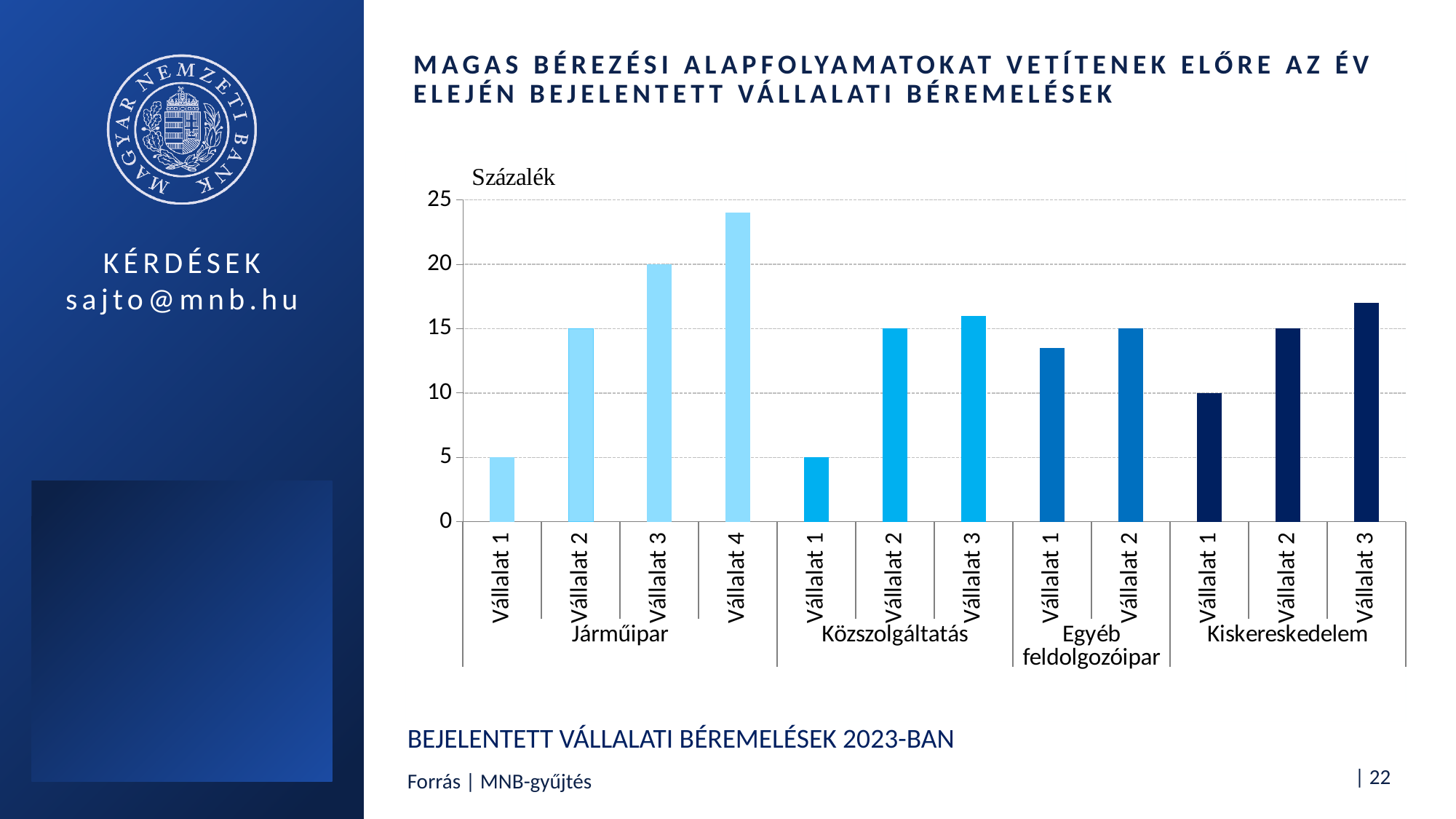
Is the value for Vállalat 4 in the Járműipar group greater or less than 20? greater What is the value for Vállalat 2 in the Közszolgáltatás group? 15 How many bars are plotted on the chart in total? 12 What is the value for Vállalat 1 in the Kiskereskedelem group? 10 Which bar has the highest value on the chart? Vállalat 4 (Járműipar) Is the value for Vállalat 1 in the Egyéb feldolgozóipar group greater or less than 15? less What kind of chart is shown on the slide? Bar chart What is the difference between Vállalat 3 and Vállalat 1 in the Járműipar group? 15 Is the value for Vállalat 3 in the Kiskereskedelem group greater or less than 15? greater What unit is shown at the top of the vertical axis? Százalék What is the value for Vállalat 3 in the Járműipar group? 20 What is the value for Vállalat 1 in the Járműipar group? 5